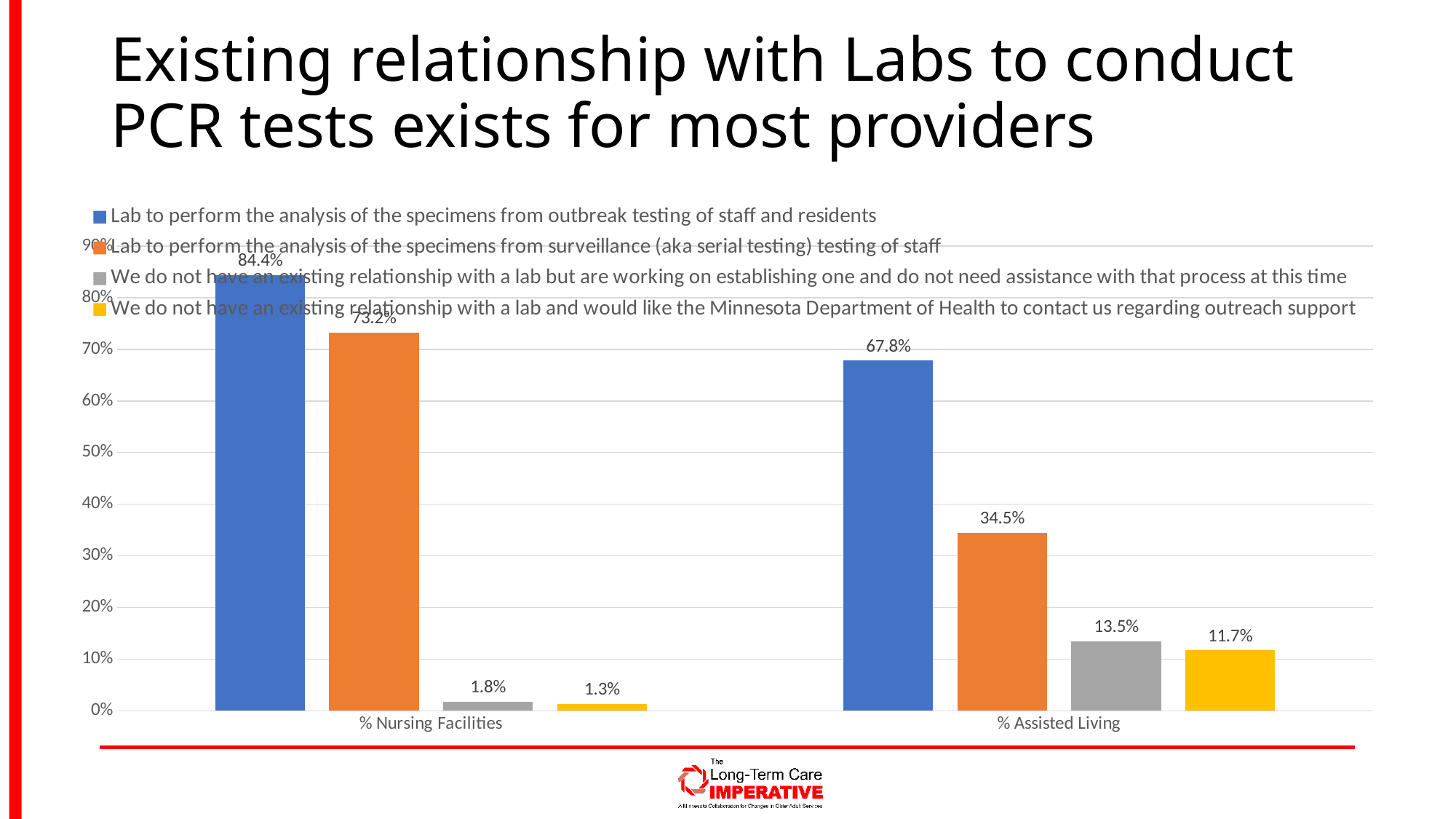
What is the value for 'We do not have an existing relationship with a lab and would like the Minnesota Department of Health to contact us regarding outreach support' for % Nursing Facilities? 1.3% How many categories are shown on the x axis? 2 Is the value for 'Lab to perform the analysis of the specimens from surveillance (aka serial testing) testing of staff' for % Nursing Facilities greater or less than 70%? greater What colour are the bars for 'We do not have an existing relationship with a lab but are working on establishing one and do not need assistance with that process at this time'? gray How many series does the legend list? 4 What is the difference between the 'Lab to perform the analysis of the specimens from outbreak testing of staff and residents' values for % Nursing Facilities and % Assisted Living? 16.6% What is the value for 'Lab to perform the analysis of the specimens from outbreak testing of staff and residents' for % Nursing Facilities? 84.4% Which series has the lowest value for % Assisted Living? We do not have an existing relationship with a lab and would like the Minnesota Department of Health to contact us regarding outreach support What kind of chart is shown on the slide? bar chart What is the value for 'We do not have an existing relationship with a lab but are working on establishing one and do not need assistance with that process at this time' for % Assisted Living? 13.5% What is the value for 'Lab to perform the analysis of the specimens from surveillance (aka serial testing) testing of staff' for % Assisted Living? 34.5% Which category has the higher value for 'Lab to perform the analysis of the specimens from outbreak testing of staff and residents'? % Nursing Facilities